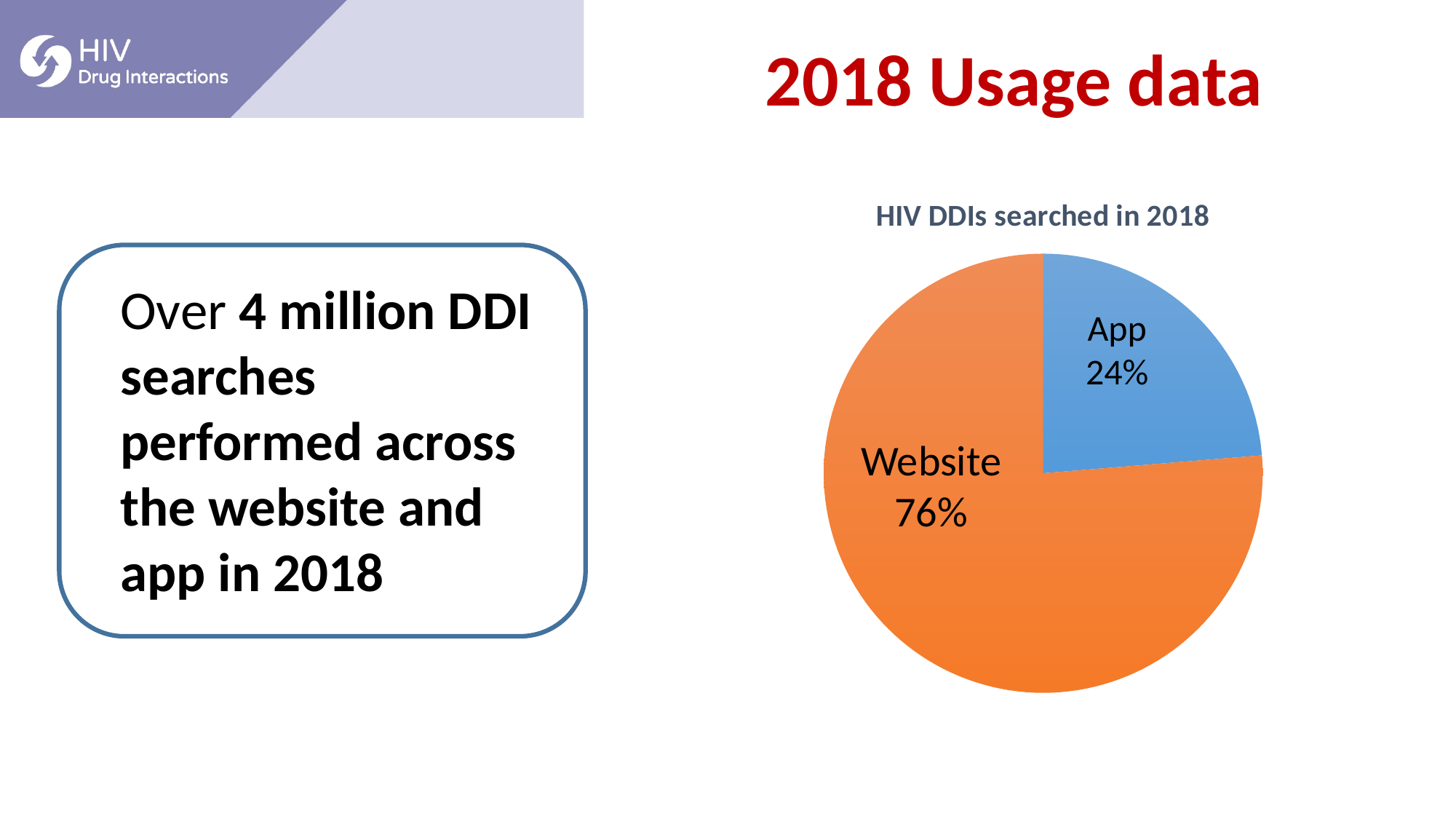
What share of HIV DDIs searched in 2018 came from the Website? 76% What kind of chart is shown on the slide? pie chart Which slice of the pie is the largest? Website What share of HIV DDIs searched in 2018 came from the App? 24% Which is larger, the Website share or the App share? Website What colour is the Website slice? orange Which slice of the pie is the smallest? App How many slices does the pie chart have? 2 What is the title of the chart? HIV DDIs searched in 2018 What is the difference in percentage points between the Website and App shares? 52